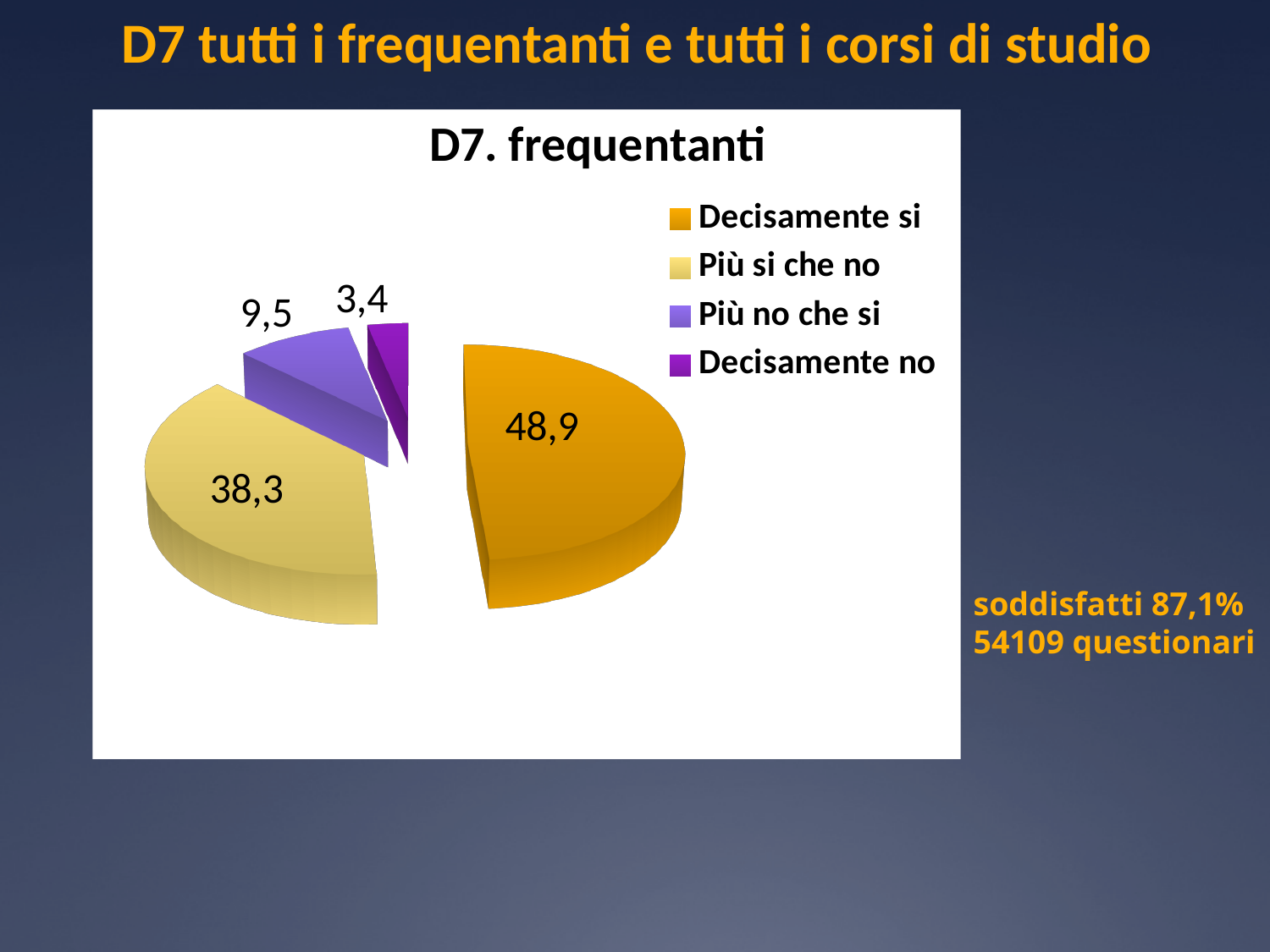
What is the value for "Decisamente no" in the pie chart? 3,4 Which category has the smallest slice in the pie chart? Decisamente no Which category has the largest slice in the pie chart? Decisamente si Which is larger, the value for "Più si che no" or the value for "Più no che si"? Più si che no What is the difference between the values for "Decisamente si" and "Più si che no"? 10,6 What kind of chart is shown on the slide? Pie chart What is the value for "Più si che no" in the pie chart? 38,3 What is the title of the chart? D7. frequentanti What is the difference between the values for "Più no che si" and "Decisamente no"? 6,1 What is the value for "Decisamente si" in the pie chart? 48,9 How many slices does the pie chart have? 4 What is the value for "Più no che si" in the pie chart? 9,5